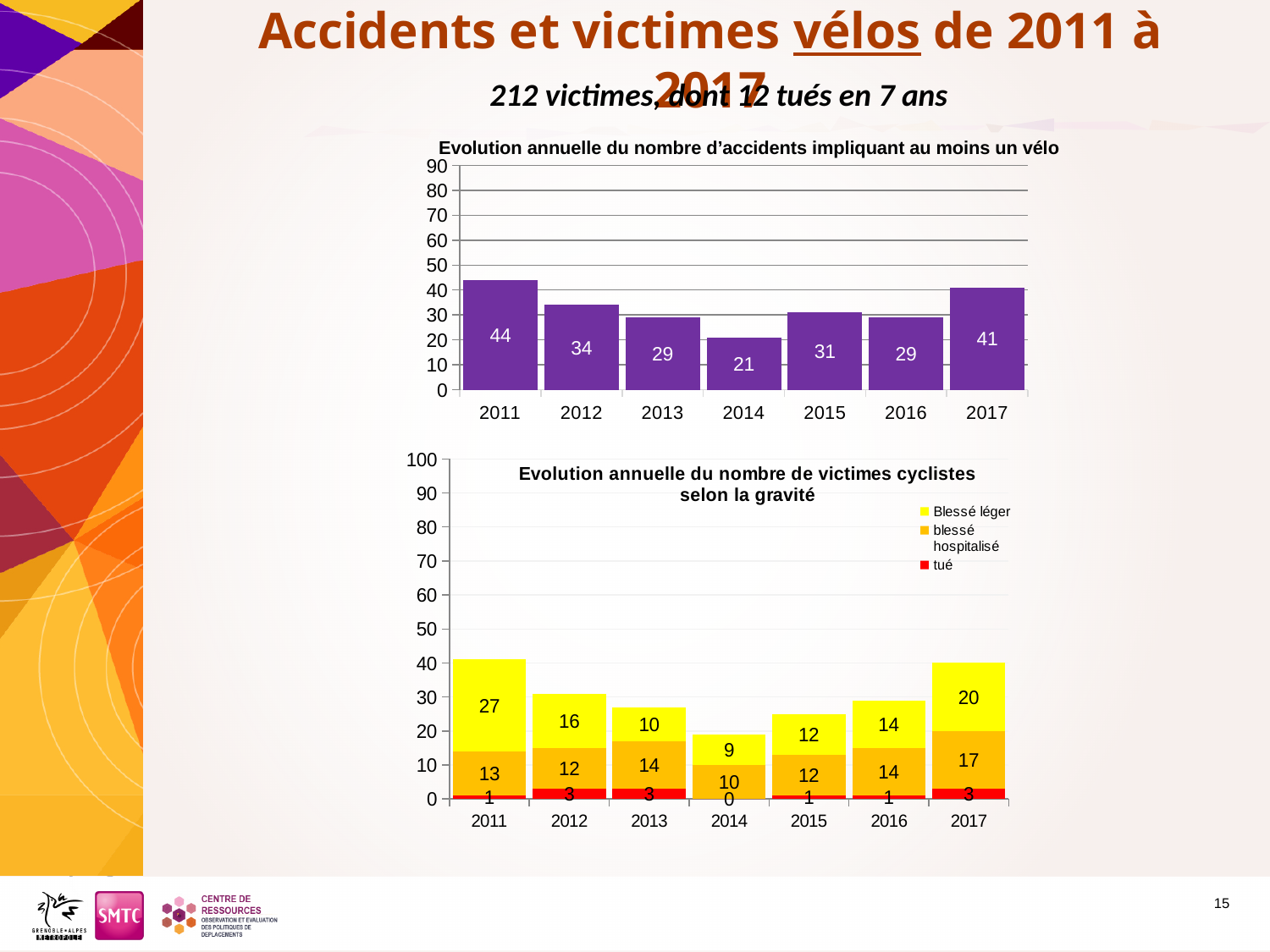
In the top chart (Evolution annuelle du nombre d'accidents impliquant au moins un vélo), which year has the lowest value? 2014 In the bottom chart (Evolution annuelle du nombre de victimes cyclistes selon la gravité), what is the value for tué in 2014? 0 In the top chart (Evolution annuelle du nombre d'accidents impliquant au moins un vélo), what is the difference between the values for 2011 and 2017? 3 In the top chart (Evolution annuelle du nombre d'accidents impliquant au moins un vélo), how many years are shown on the x axis? 7 In the bottom chart (Evolution annuelle du nombre de victimes cyclistes selon la gravité), what is the total of the stacked bar for 2017? 40 In the bottom chart (Evolution annuelle du nombre de victimes cyclistes selon la gravité), what is the value for Blessé léger in 2011? 27 In the bottom chart (Evolution annuelle du nombre de victimes cyclistes selon la gravité), how many series does the legend list? 3 In the bottom chart (Evolution annuelle du nombre de victimes cyclistes selon la gravité), which colour represents the tué series? Red In the bottom chart (Evolution annuelle du nombre de victimes cyclistes selon la gravité), which is larger: blessé hospitalisé in 2013 or blessé hospitalisé in 2014? 2013 In the top chart (Evolution annuelle du nombre d'accidents impliquant au moins un vélo), which year has the highest value? 2011 What kind of chart is the top chart (Evolution annuelle du nombre d'accidents impliquant au moins un vélo)? Bar chart In the top chart (Evolution annuelle du nombre d'accidents impliquant au moins un vélo), what is the value for 2014? 21